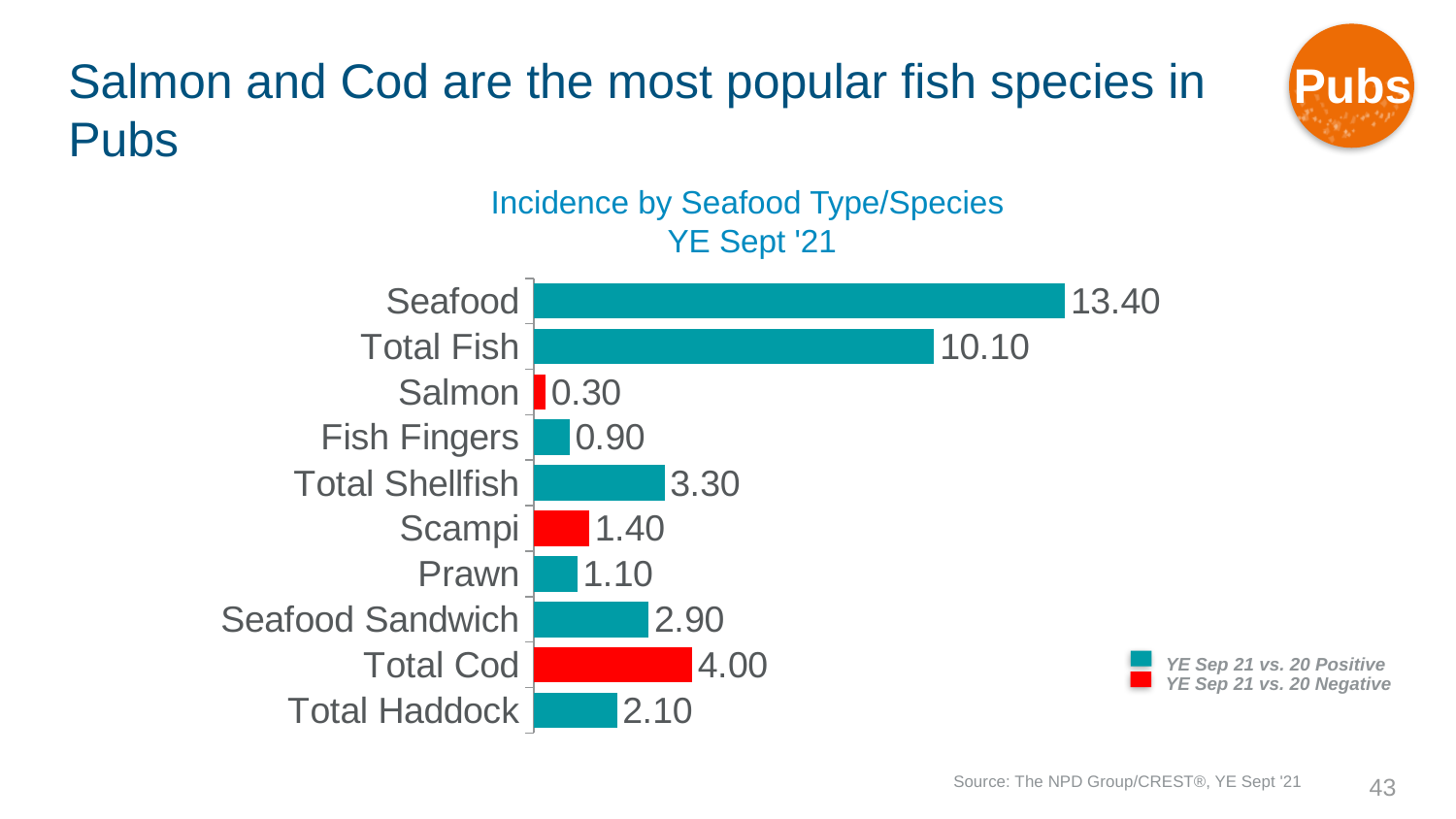
How many entries does the legend list? 2 Which is larger, the value for Total Shellfish or the value for Seafood Sandwich? Total Shellfish What is the value for Seafood? 13.40 Which categories are shown in red (YE Sep 21 vs. 20 Negative)? Salmon, Scampi, Total Cod What is the difference between the values for Seafood and Total Fish? 3.30 Which category has the highest value? Seafood What is the value for Scampi? 1.40 What is the value for Total Cod? 4.00 What kind of chart is shown on the slide? Bar chart Which category has the lowest value? Salmon How many categories are shown in the chart? 10 What is the difference between the values for Total Cod and Total Haddock? 1.90